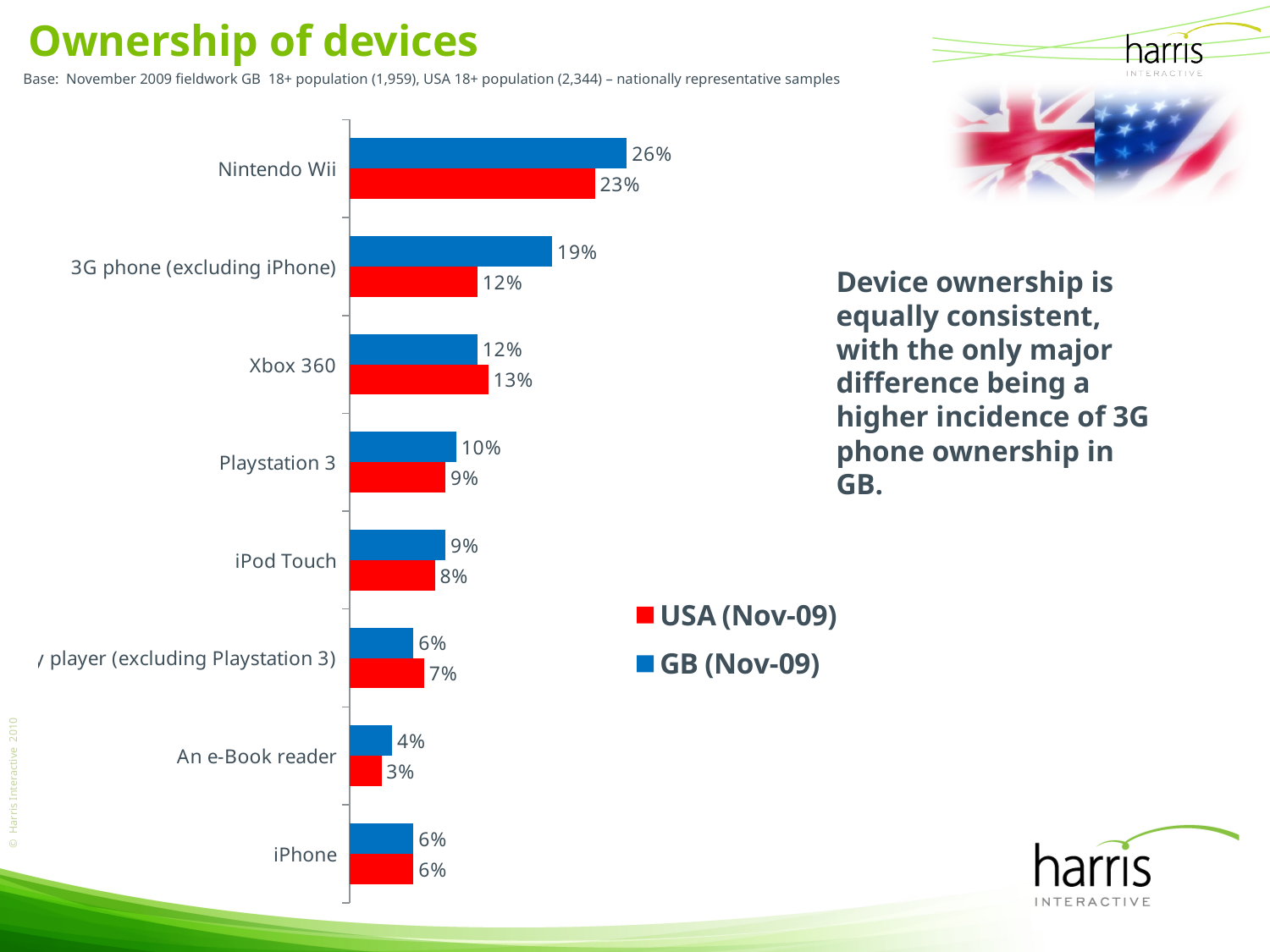
Which colour represents the USA (Nov-09) series? Red What is the GB (Nov-09) ownership value for Nintendo Wii? 26% What is the USA (Nov-09) ownership value for 3G phone (excluding iPhone)? 12% What is the USA (Nov-09) value for Xbox 360? 13% For Xbox 360, which is larger: the USA (Nov-09) value or the GB (Nov-09) value? USA (Nov-09) How many devices are listed on the chart? 8 What type of chart is shown on the slide? Bar chart What is the difference between the GB (Nov-09) and USA (Nov-09) values for 3G phone (excluding iPhone)? 7% How many series does the legend list? 2 Which device has the lowest USA (Nov-09) ownership? An e-Book reader Which device has the highest GB (Nov-09) ownership? Nintendo Wii What is the GB (Nov-09) value for An e-Book reader? 4%